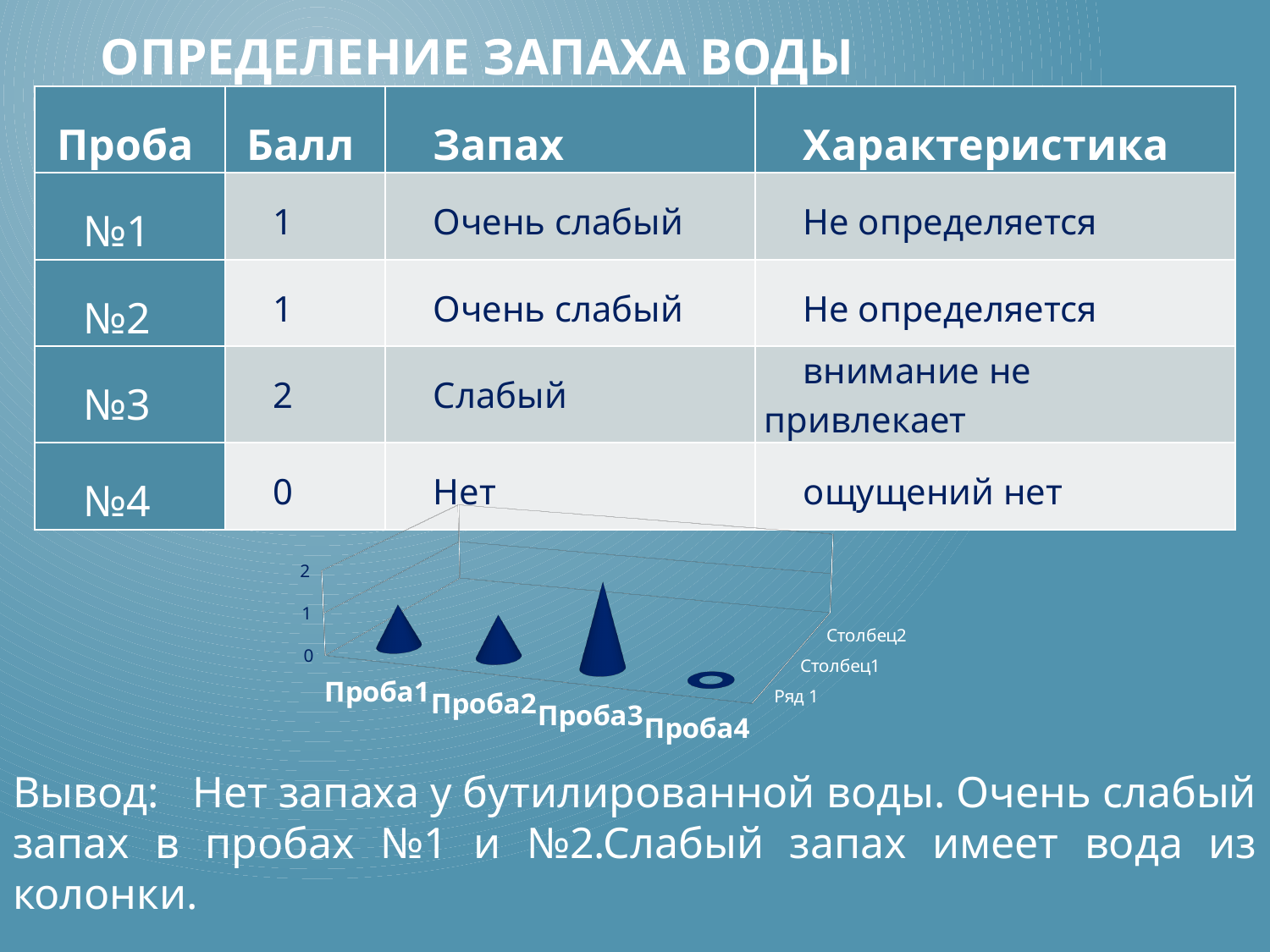
Is the value for Проба4 greater or less than 1? less Is the value for Проба1 greater or less than 2? less What is the highest tick value shown on the chart's vertical axis? 2 What kind of chart is shown on the slide? bar chart Which category has the lowest value in the chart? Проба4 Which is larger, the value for Проба3 or the value for Проба1? Проба3 Is the value for Проба3 larger than the value for Проба4? yes What is the label of the first category on the chart's horizontal axis? Проба1 How many categories are shown on the chart's horizontal axis? 4 Which category has the tallest cone in the chart? Проба3 Is the value for Проба3 greater or less than 1? greater